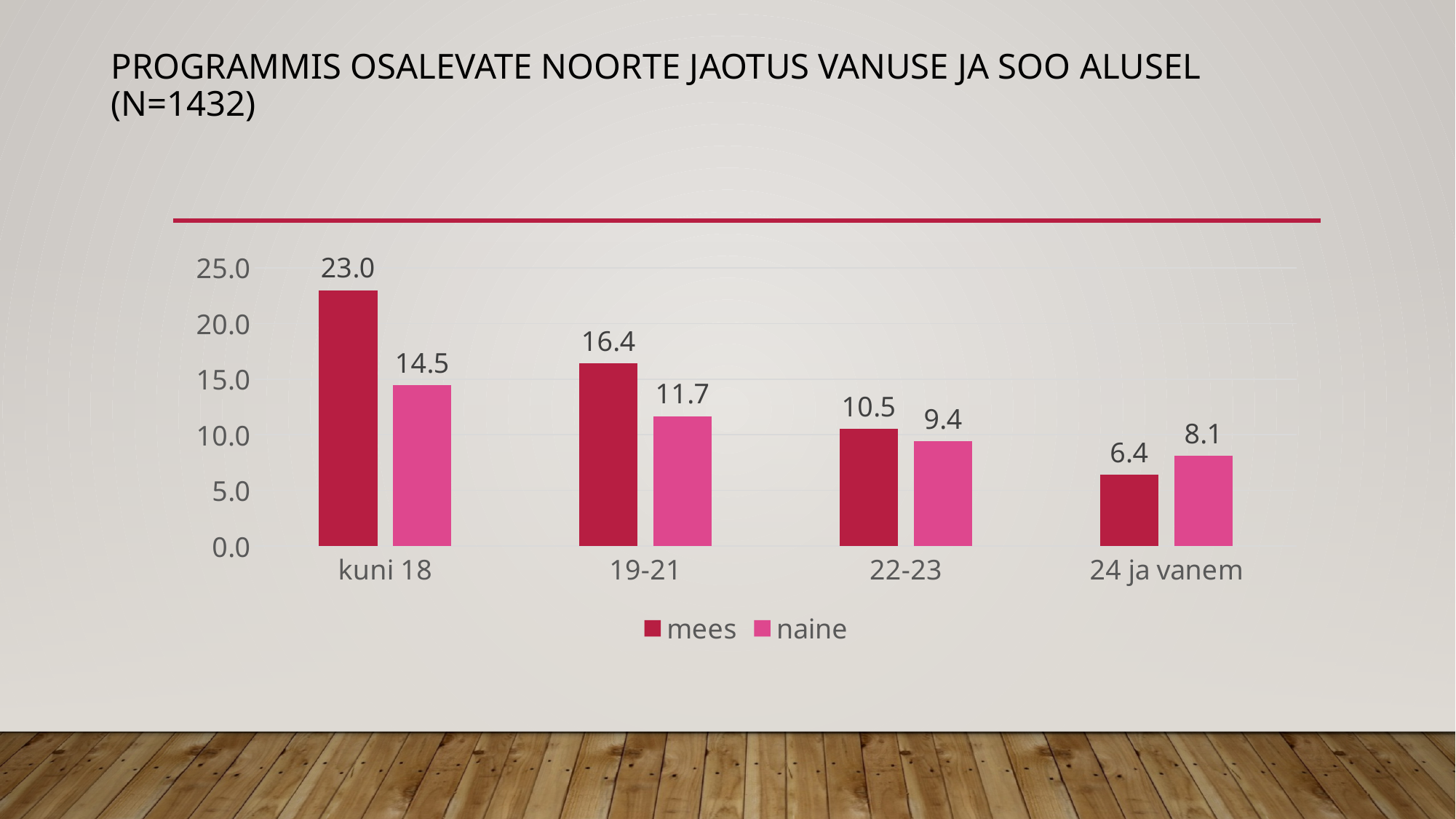
How many series does the legend list? 2 What is the value for mees in the kuni 18 category? 23.0 Which age category has the lowest value for naine? 24 ja vanem What kind of chart is shown on the slide? bar chart Is the value for mees in the 22-23 category greater or less than 10.0? greater Which age category has the highest value for mees? kuni 18 What is the difference between the mees and naine values in the kuni 18 category? 8.5 In the 24 ja vanem category, which series has the larger value, mees or naine? naine What is the value for naine in the 19-21 category? 11.7 What is the value for naine in the 24 ja vanem category? 8.1 Do the mees values rise or fall from kuni 18 to 24 ja vanem? fall How many age categories are shown on the x axis? 4